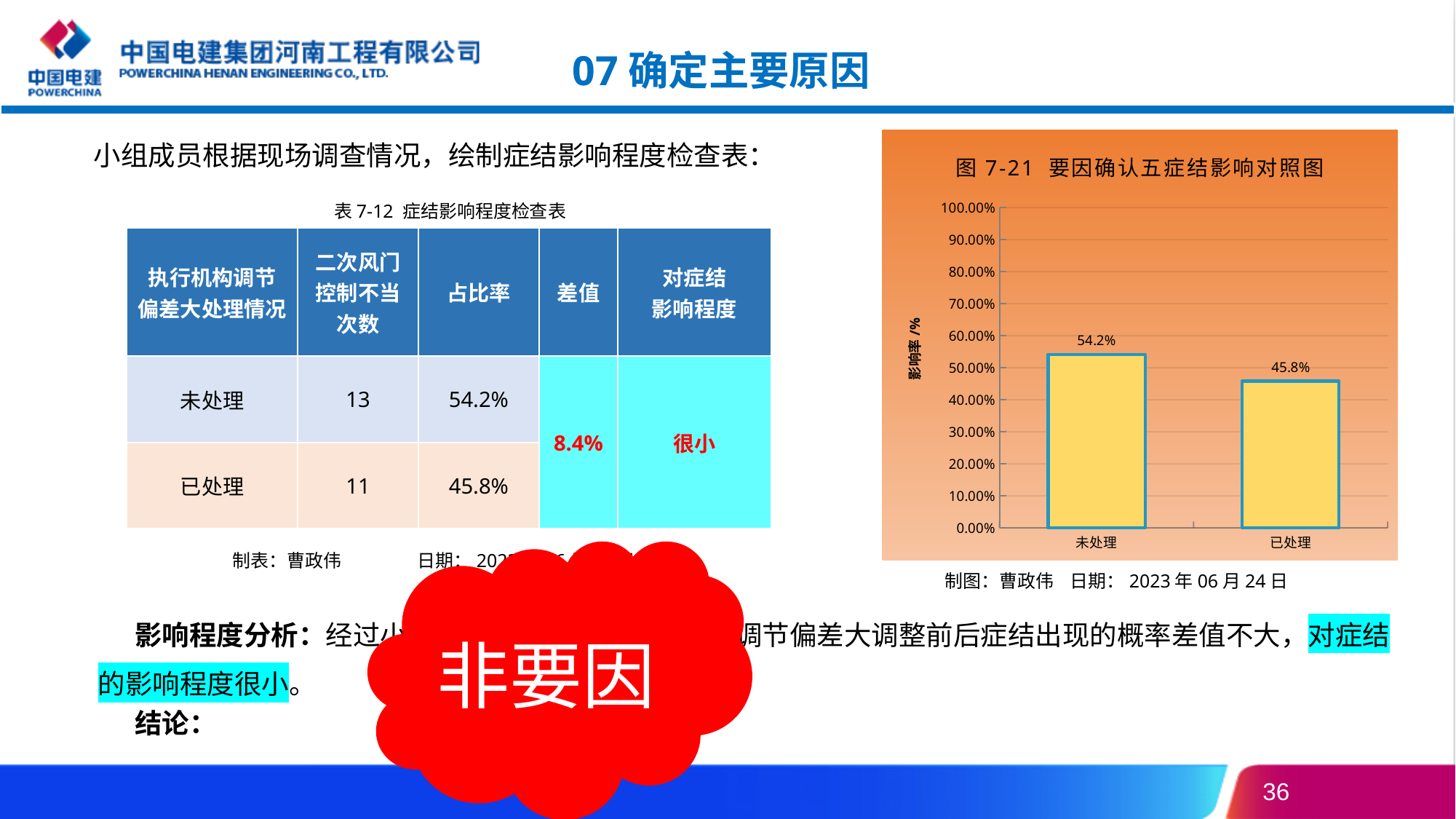
What is the title of the chart? 图 7-21 要因确认五症结影响对照图 Is the value for 已处理 greater or less than 50.00%? less Which is larger in the chart, the value for 未处理 or the value for 已处理? 未处理 What is the value for 未处理 in the chart? 54.2% Which category has the lowest value in the chart? 已处理 What is the label of the y axis of the chart? 影响率 /% Which category has the highest value in the chart? 未处理 Is the value for 未处理 greater or less than 50.00%? greater What kind of chart is shown on the slide? bar chart How many categories are shown on the x axis of the chart? 2 What is the difference between the values for 未处理 and 已处理 in the chart? 8.4% What is the value for 已处理 in the chart? 45.8%